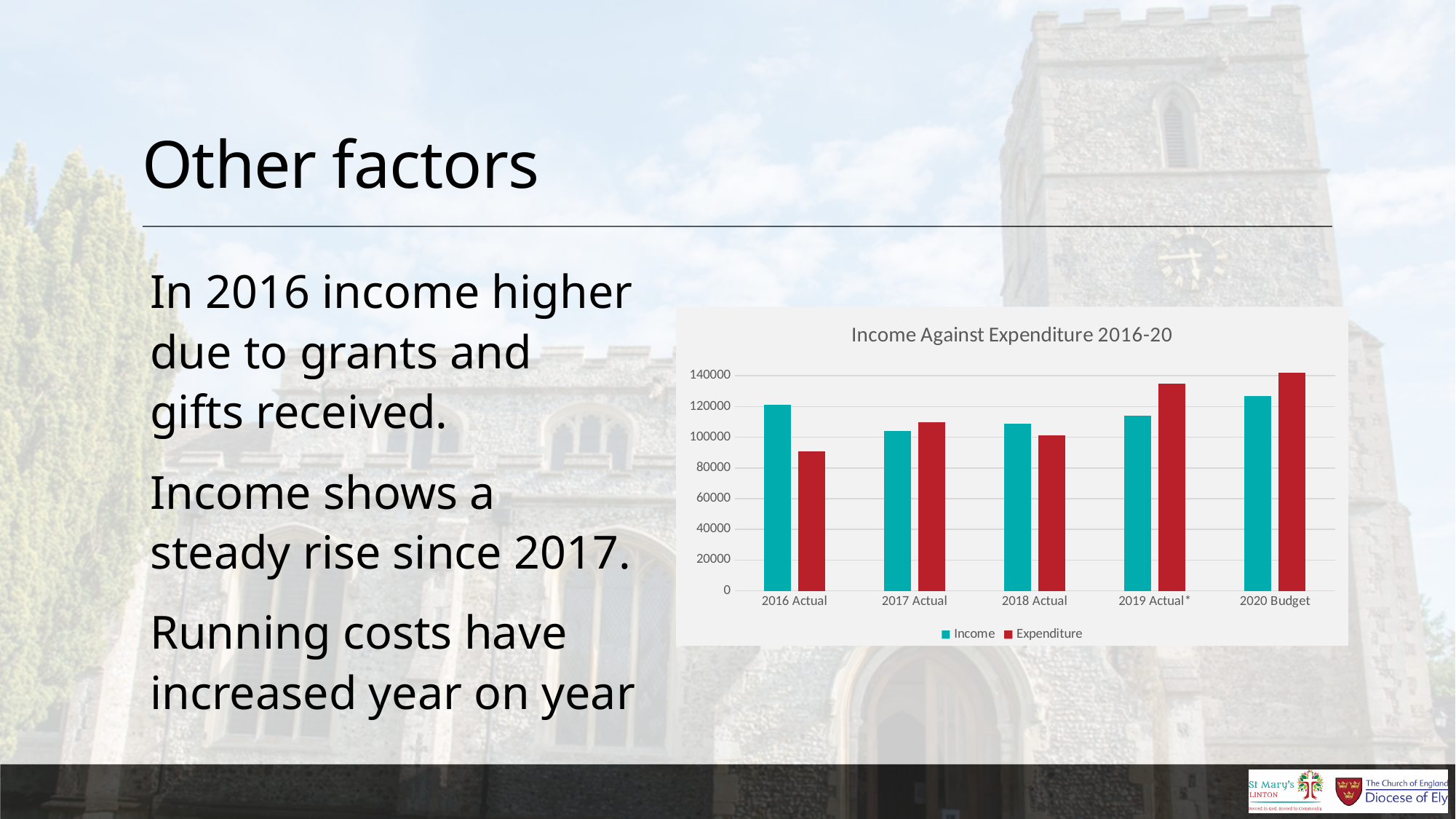
For 2016 Actual, which is larger, Income or Expenditure? Income Which category has the lowest Income value? 2017 Actual Which category has the highest Expenditure value? 2020 Budget How many series does the chart legend list? 2 What kind of chart is shown on the slide? Bar chart Does the Income series rise or fall from 2017 Actual to 2020 Budget? Rise Which category has the lowest Expenditure value? 2016 Actual How many categories are shown on the x axis of the chart? 5 Is the Expenditure value for 2019 Actual* greater or less than 120000? greater For 2019 Actual*, which is larger, Income or Expenditure? Expenditure What is the title of the chart? Income Against Expenditure 2016-20 Is the Expenditure value for 2016 Actual greater or less than 100000? less